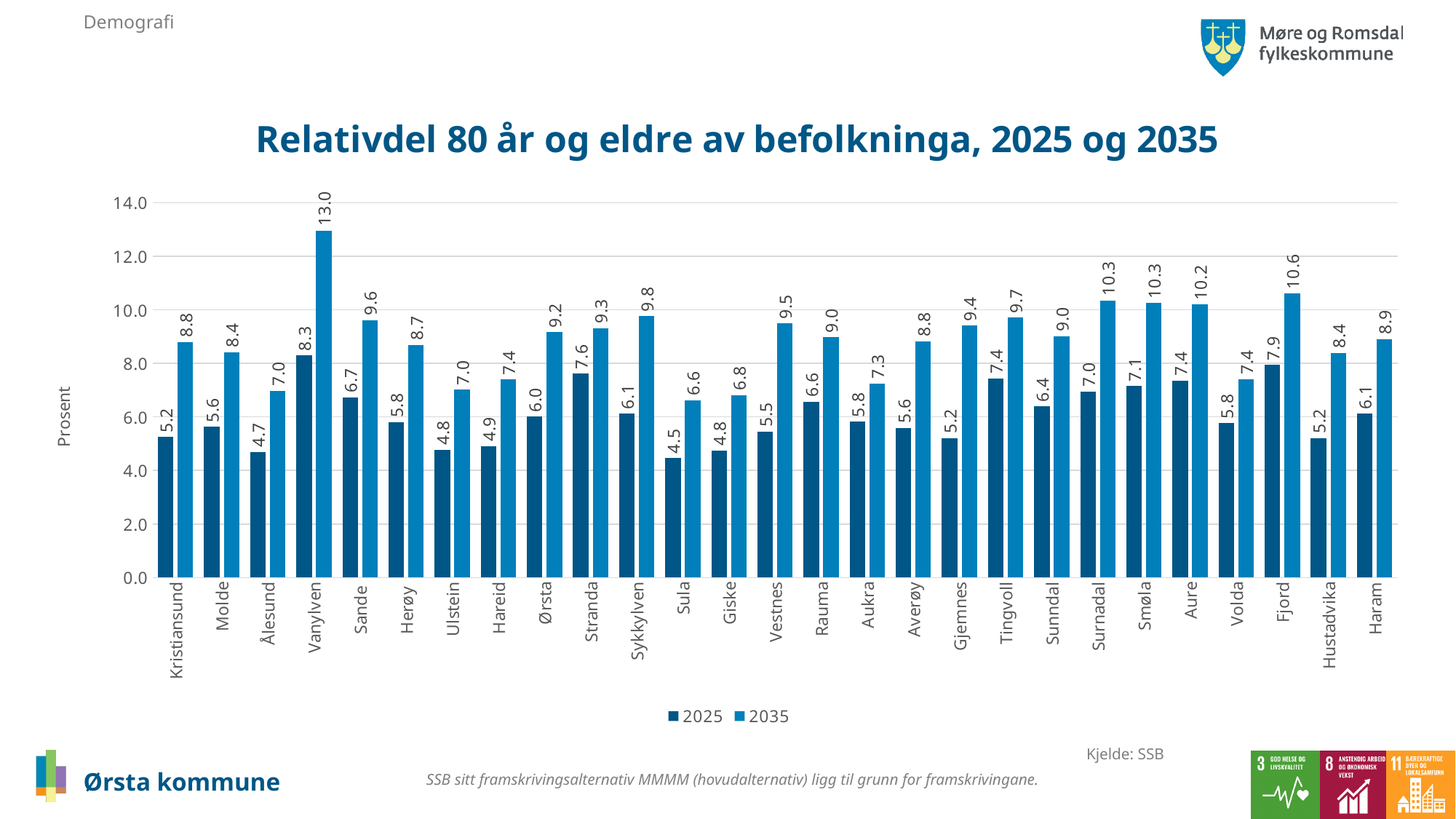
Which municipality has the lowest value in the 2025 series? Sula Which municipality has the highest value in the 2035 series? Vanylven Is the 2035 value for Vanylven greater or less than 12.0? greater How many municipalities are shown on the x axis? 27 What is the value for Vanylven in the 2035 series? 13.0 What is the difference between the 2035 and 2025 values for Ørsta? 3.2 What is the value for Volda in the 2035 series? 7.4 How many series does the legend list? 2 Which municipality has the lowest value in the 2035 series? Sula What kind of chart is shown on the slide? Bar chart What is the value for Ørsta in the 2025 series? 6.0 Which is larger: the 2025 value for Fjord or the 2025 value for Stranda? Fjord